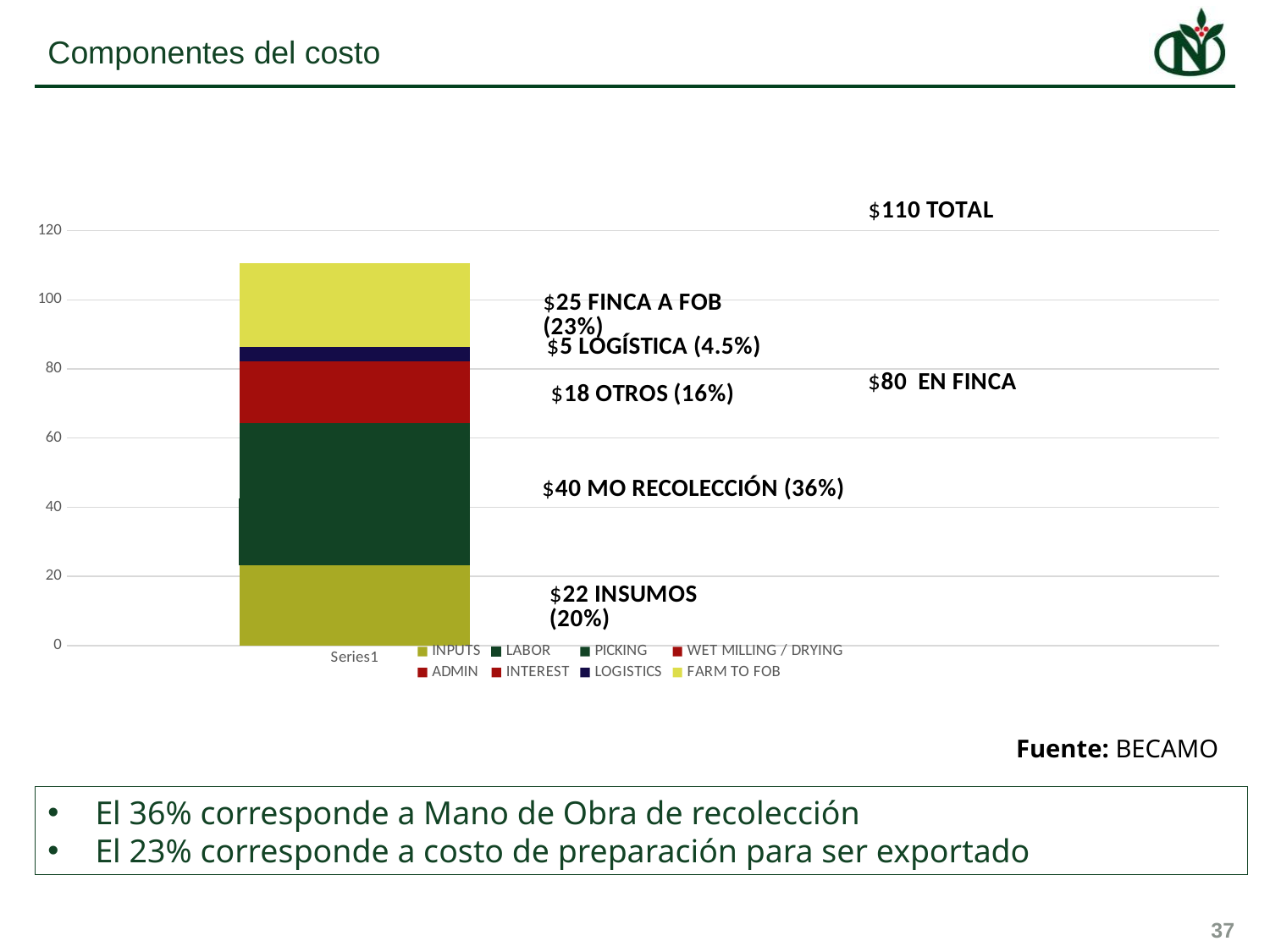
How many bars are plotted in the chart? 1 What is the value labelled EN FINCA? $80 What is the value labelled for INSUMOS? $22 What percentage share is shown for MO RECOLECCIÓN? 36% What is the value labelled for MO RECOLECCIÓN? $40 Which labelled cost component is the largest? MO RECOLECCIÓN What is the total cost shown for the stacked bar? $110 What kind of chart is shown on the slide? Stacked bar chart How many series does the chart legend list? 8 What is the value labelled for LOGÍSTICA? $5 What is the value labelled for FINCA A FOB? $25 What is the difference between the MO RECOLECCIÓN value and the INSUMOS value? $18